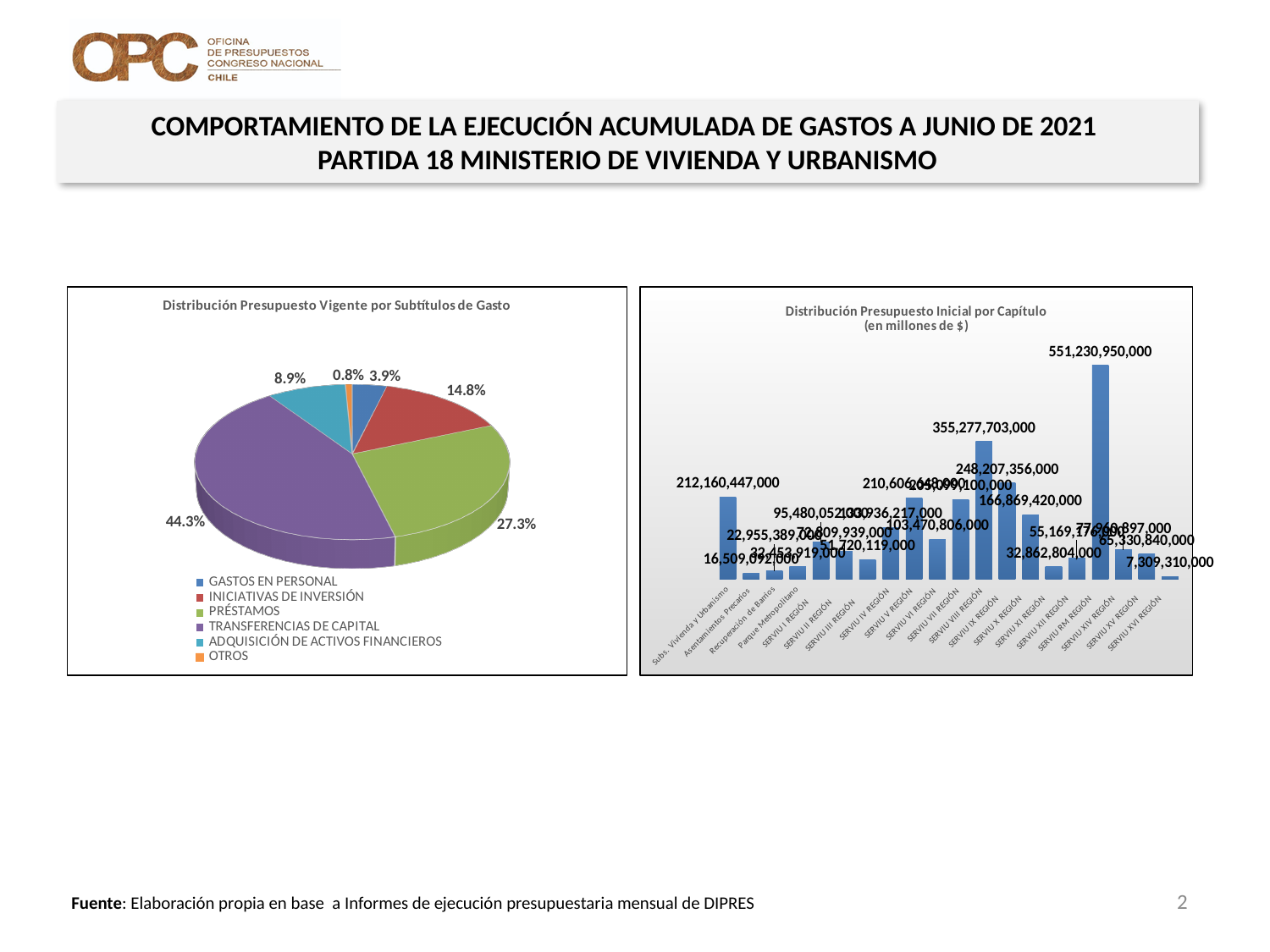
On the right bar chart, which capítulo has the highest value? SERVIU RM REGIÓN On the left pie chart, which category has the largest share? TRANSFERENCIAS DE CAPITAL On the left pie chart, what is the difference in percentage points between TRANSFERENCIAS DE CAPITAL and PRÉSTAMOS? 17.0 percentage points On the right bar chart, which is larger: Subs. Vivienda y Urbanismo or Asentamientos Precarios? Subs. Vivienda y Urbanismo On the right chart, what kind of chart is 'Distribución Presupuesto Inicial por Capítulo'? Bar chart On the left pie chart, what share does INICIATIVAS DE INVERSIÓN have? 14.8% On the left pie chart, what share does PRÉSTAMOS have? 27.3% On the left pie chart, which category has the smallest share? OTROS On the right bar chart, what is the value for Subs. Vivienda y Urbanismo? 212,160,447,000 On the left pie chart, how many categories does the legend list? 6 On the left chart, what kind of chart is 'Distribución Presupuesto Vigente por Subtítulos de Gasto'? Pie chart On the right bar chart, what is the value for SERVIU RM REGIÓN? 551,230,950,000